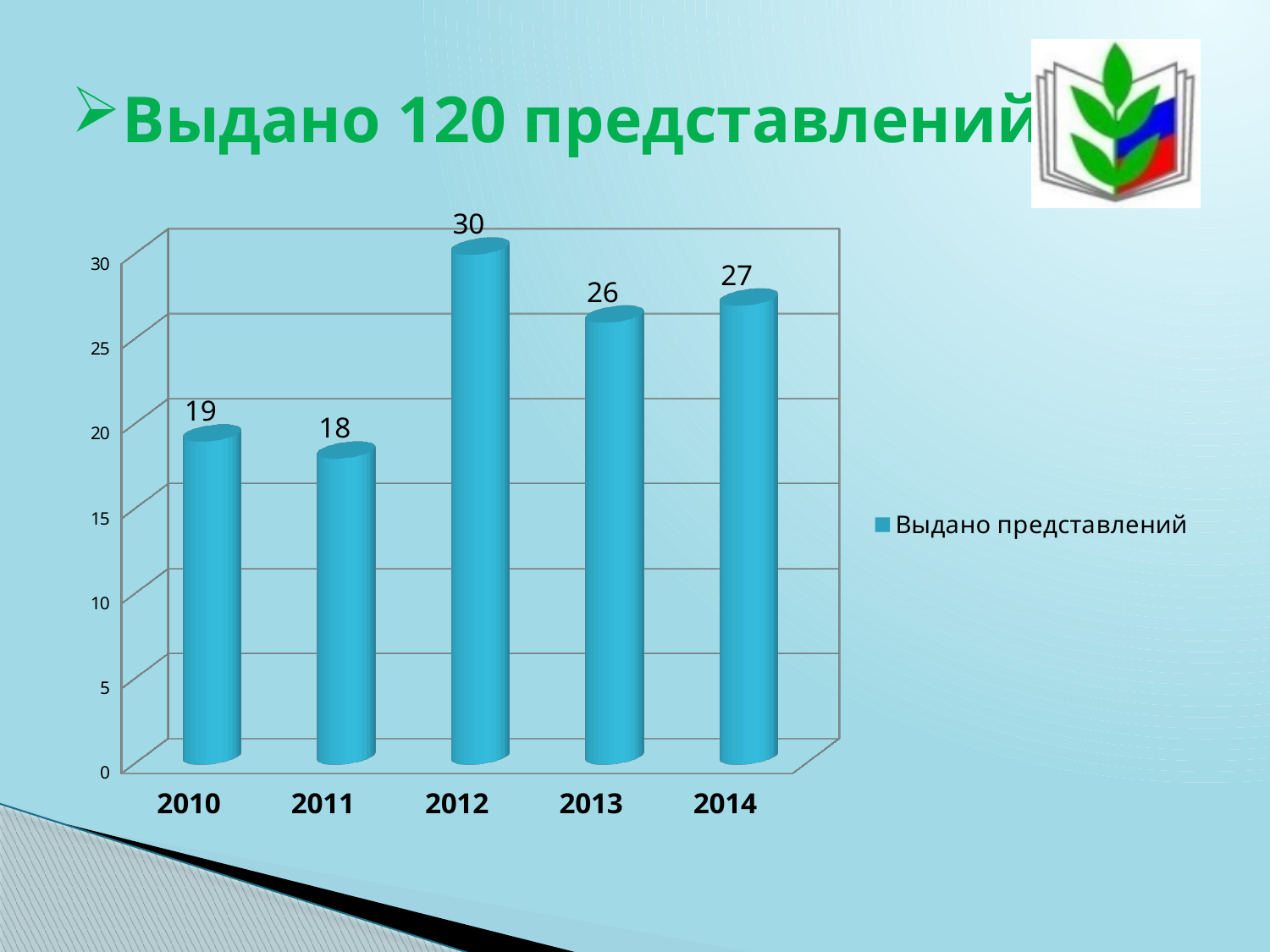
What is the value for 2014? 27 What is the legend entry of the chart? Выдано представлений How many years are shown on the x axis? 5 Which is larger, the value for 2013 or the value for 2010? 2013 Which year has the highest value? 2012 Which year has the lowest value? 2011 What is the value for 2012? 30 Is the value for 2013 greater or less than 20? greater What is the difference between the values for 2012 and 2011? 12 What is the value for 2010? 19 What kind of chart is shown on the slide? bar chart What is the difference between the values for 2014 and 2013? 1